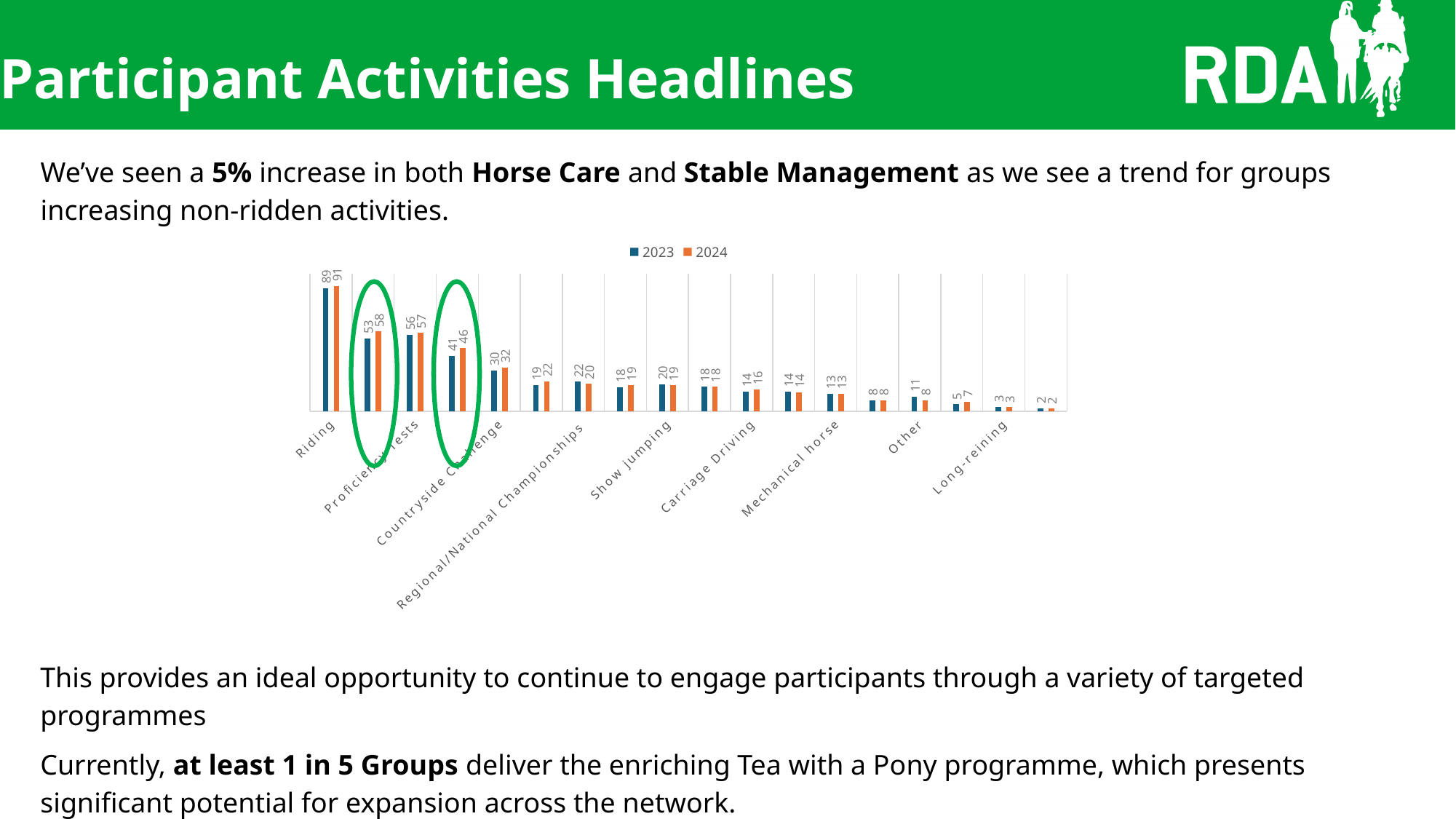
What is the 2023 value for Proficiency Tests? 56 Which colour represents the 2024 series? Orange For Riding, which year has the larger value, 2023 or 2024? 2024 What is the 2024 value for Countryside Challenge? 32 Which category has the highest value in 2024? Riding What is the difference between the 2024 and 2023 values for Riding? 2 For Other, which year has the larger value, 2023 or 2024? 2023 What are the two series named in the legend? 2023 and 2024 What is the 2023 value for Riding? 89 What kind of chart is shown on the slide? Bar chart What is the 2024 value for Riding? 91 How many series does the legend list? 2